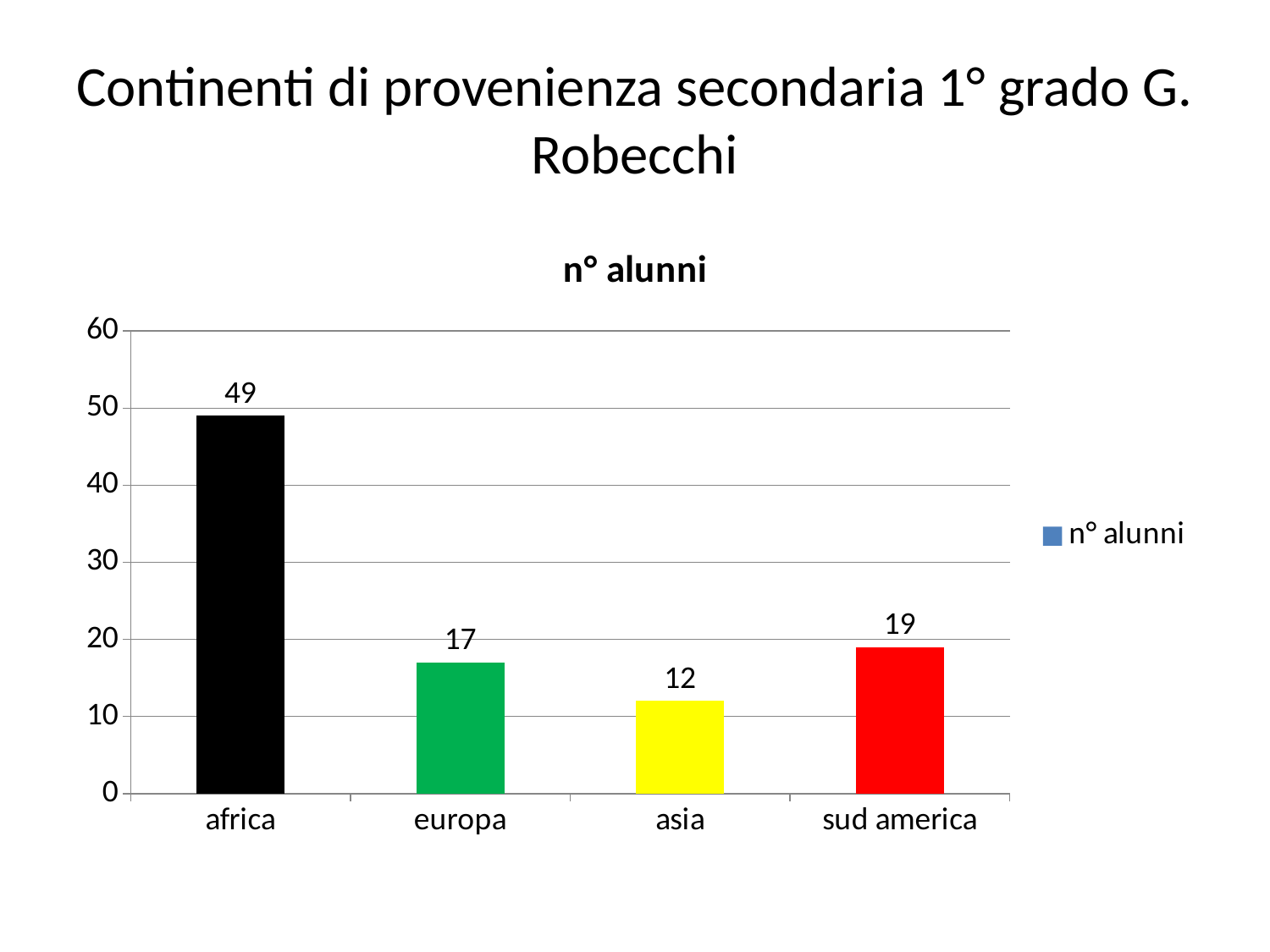
What is the value for asia? 12 What is the title of the chart? n° alunni What is the value for africa? 49 What kind of chart is shown on the slide? bar chart What is the value for sud america? 19 How many categories are shown on the x axis? 4 What is the difference between the values for africa and sud america? 30 Which is larger, the value for europa or the value for sud america? sud america What is the value for europa? 17 Is the value for africa greater or less than 40? greater Which continent has the lowest number of alunni? asia Which continent has the highest number of alunni? africa